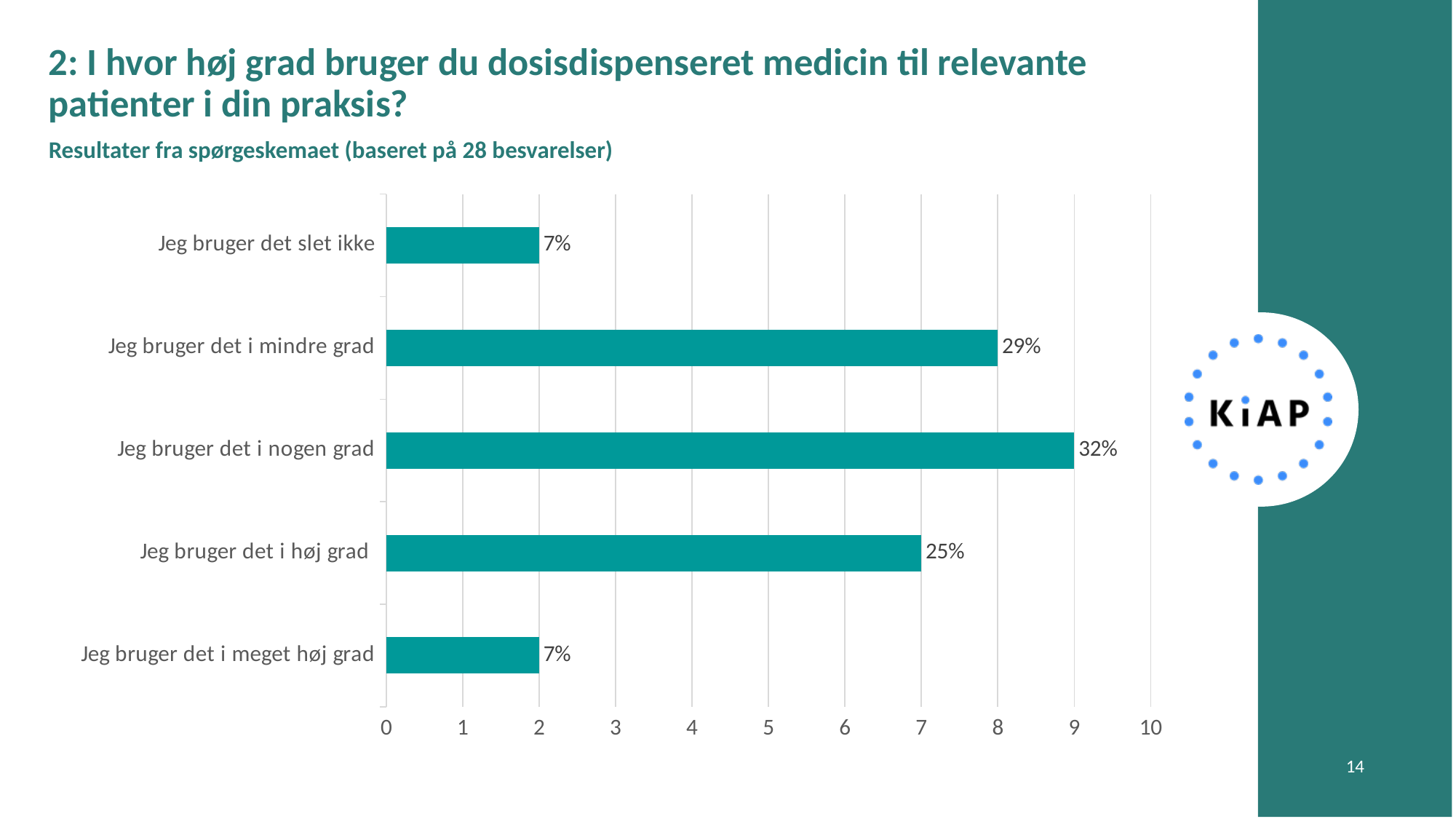
Is the bar for "Jeg bruger det i høj grad" greater or less than 5 on the x axis? greater What is the difference in percentage points between "Jeg bruger det i nogen grad" and "Jeg bruger det i høj grad"? 7 Which is larger, the value for "Jeg bruger det i mindre grad" or "Jeg bruger det i høj grad"? Jeg bruger det i mindre grad What kind of chart is shown on the slide? Bar chart How many respondents does the bar for "Jeg bruger det i mindre grad" reach on the x axis? 8 What percentage label is shown for "Jeg bruger det i mindre grad"? 29% According to the subtitle, how many responses is the chart based on? 28 What percentage label is shown for "Jeg bruger det i nogen grad"? 32% Which category has the highest value? Jeg bruger det i nogen grad How many categories are shown in the chart? 5 What percentage label is shown for "Jeg bruger det i høj grad"? 25% What percentage label is shown for "Jeg bruger det slet ikke"? 7%